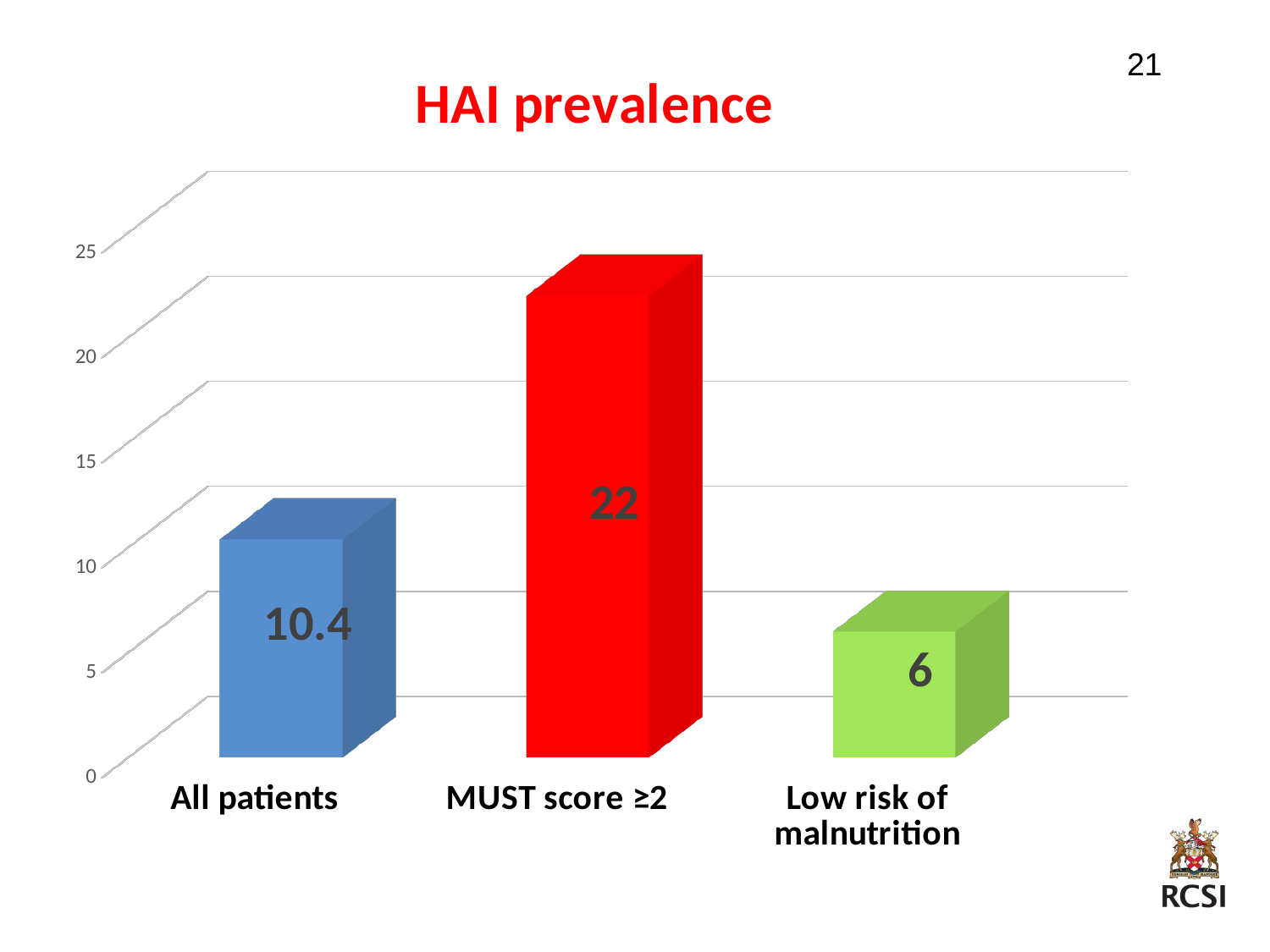
What is the HAI prevalence value for Low risk of malnutrition? 6 Which category has the highest HAI prevalence? MUST score ≥2 What kind of chart is shown on the slide? Bar chart Is the value for MUST score ≥2 greater or less than 20? greater What is the HAI prevalence value for All patients? 10.4 What is the difference between the HAI prevalence for MUST score ≥2 and for Low risk of malnutrition? 16 What is the difference between the HAI prevalence for MUST score ≥2 and for All patients? 11.6 Which is larger, the HAI prevalence for All patients or for Low risk of malnutrition? All patients Which category has the lowest HAI prevalence? Low risk of malnutrition What is the title of the chart? HAI prevalence How many categories are shown in the chart? 3 What is the HAI prevalence value for MUST score ≥2? 22